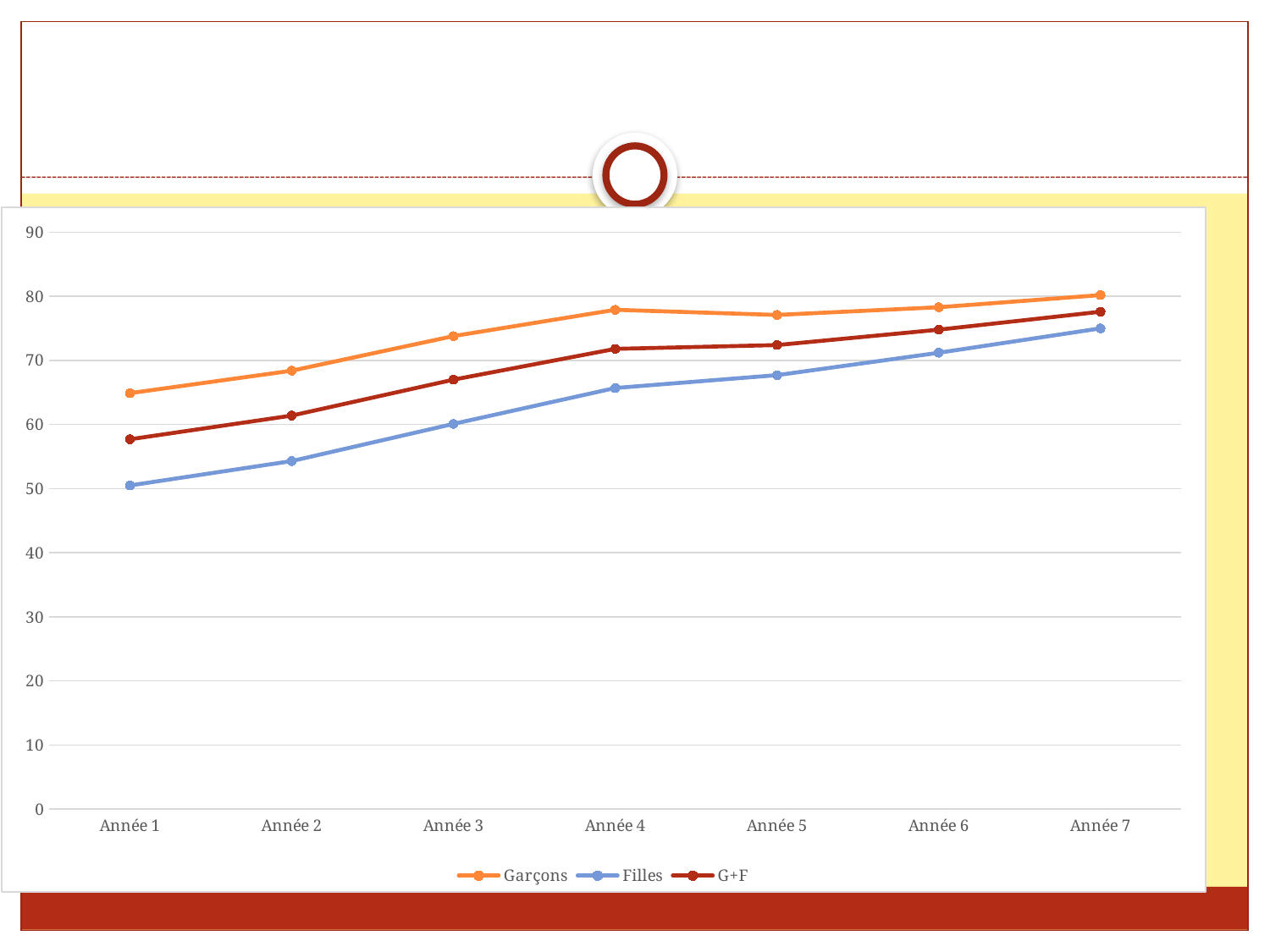
Is the value for G+F at Année 7 greater or less than 70? greater Is the value for Filles at Année 1 greater or less than 60? less How many categories are shown on the x axis? 7 Is the value for Filles at Année 4 greater or less than 60? greater In which year is the value for Filles lowest? Année 1 At Année 1, which series has the larger value, Garçons or Filles? Garçons What kind of chart is shown on the slide? line chart How many series does the legend list? 3 Do the values for Filles rise or fall from Année 1 to Année 7? rise At Année 7, which series has the larger value, Filles or G+F? G+F What colour is the line for Filles? blue